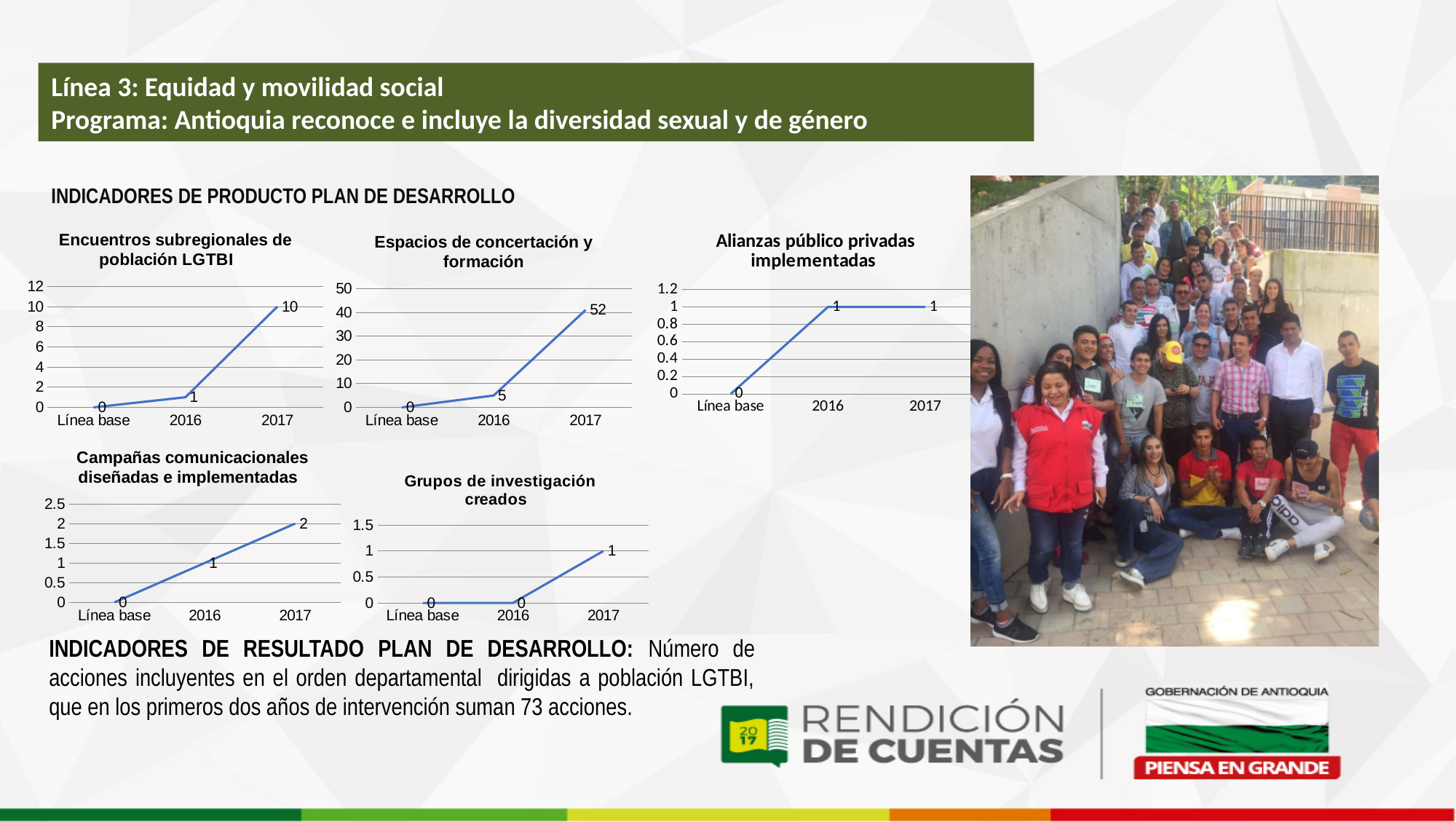
In the 'Encuentros subregionales de población LGTBI' chart, what is the difference between the 2017 and 2016 values? 9 In the 'Alianzas público privadas implementadas' chart, what is the value for 2016? 1 In the 'Encuentros subregionales de población LGTBI' chart, what is the value for 2017? 10 In the 'Espacios de concertación y formación' chart, what is the value for 2016? 5 In the 'Encuentros subregionales de población LGTBI' chart, which is larger, the value for 2016 or the value for 2017? 2017 In the 'Espacios de concertación y formación' chart, do the values rise or fall from Línea base to 2017? Rise How many charts are shown on the slide? 5 In the 'Campañas comunicacionales diseñadas e implementadas' chart, which category has the highest value? 2017 In the 'Grupos de investigación creados' chart, what is the value for 2016? 0 What kind of chart is 'Espacios de concertación y formación'? Line chart How many categories are shown on the x axis of the 'Campañas comunicacionales diseñadas e implementadas' chart? 3 In the 'Espacios de concertación y formación' chart, what is the difference between the 2017 and 2016 values? 47